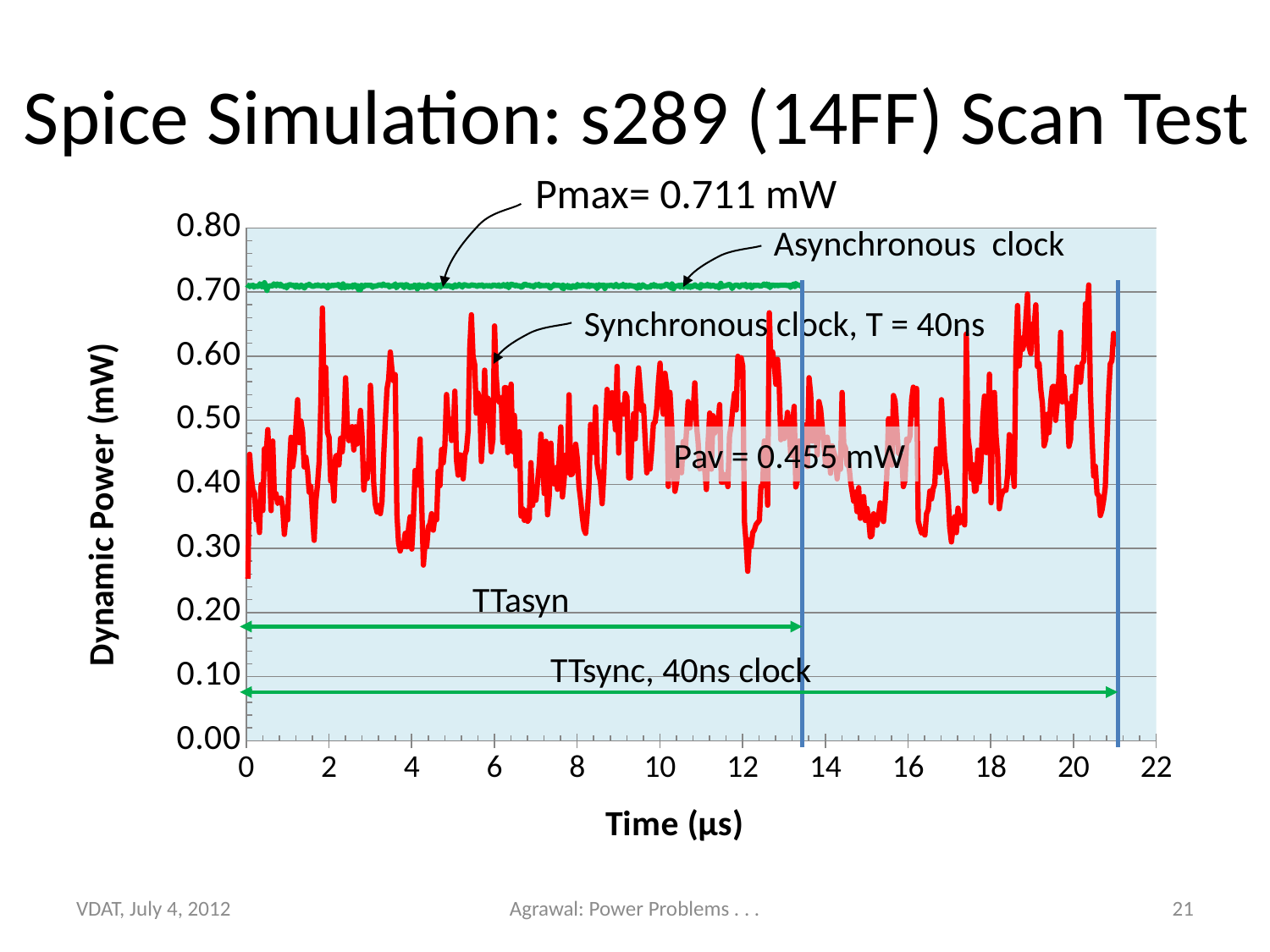
Is the dynamic power of the asynchronous clock greater or less than 0.60 mW? greater What is the label of the y axis? Dynamic Power (mW) Which test time is longer, TTasyn or TTsync? TTsync What is the label of the x axis? Time (µs) What kind of chart is shown on the slide? line chart Is the dynamic power of the synchronous clock at time 4 µs greater or less than 0.60 mW? less What is the clock period T given for the synchronous clock? 40ns Which clock shows the higher dynamic power, the asynchronous clock or the synchronous clock? Asynchronous clock What is the value of Pmax annotated on the chart? 0.711 mW What is the value of Pav annotated on the chart? 0.455 mW How many clock types are plotted on the chart? 2